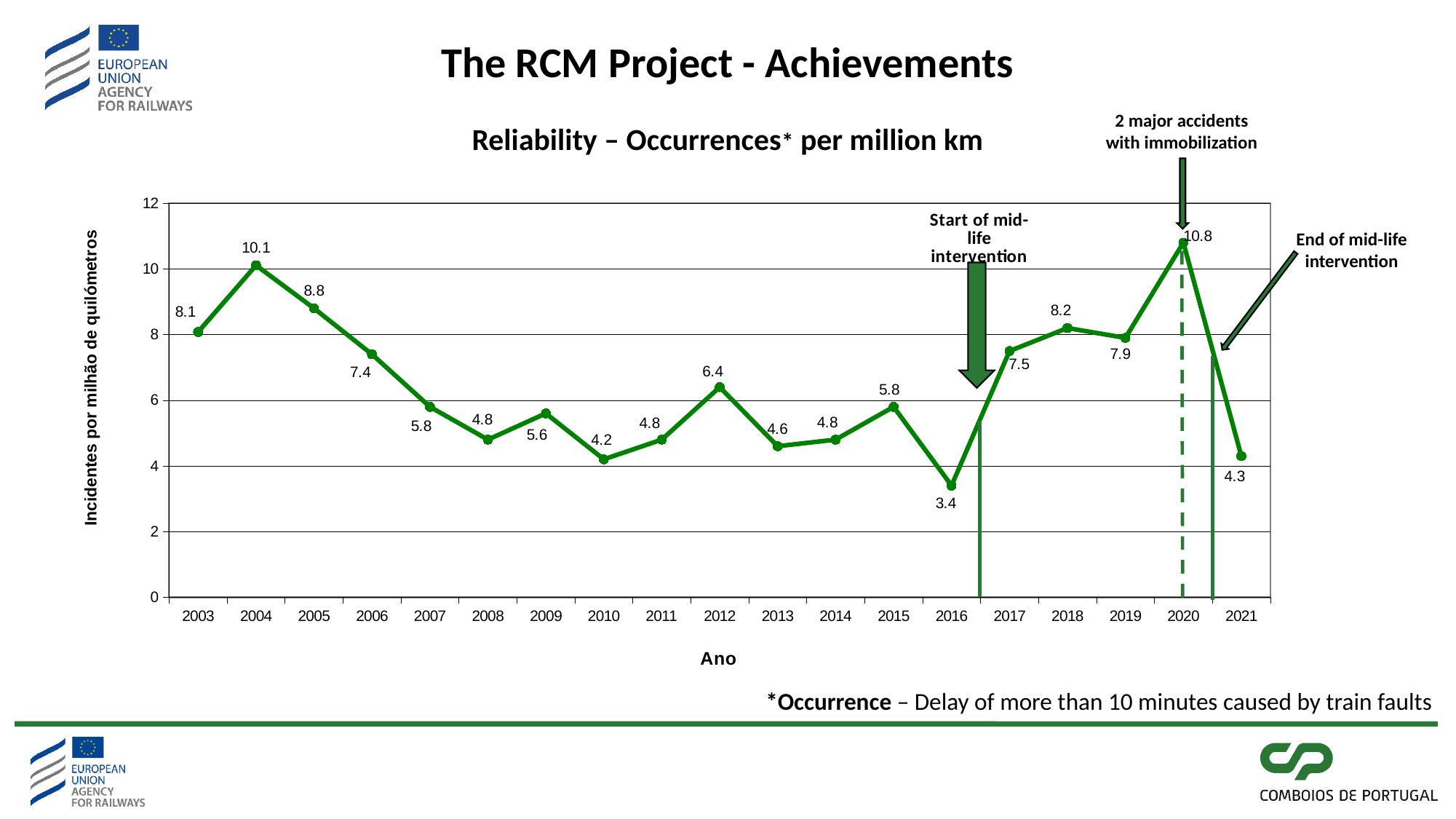
What is the title of the chart? Reliability – Occurrences* per million km What is the value for 2004? 10.1 Which year has the lowest value? 2016 Do the values rise or fall from 2004 to 2008? fall What kind of chart is shown? line chart What is the value for 2016? 3.4 Is the value for 2005 greater or less than 8? greater What is the value for 2021? 4.3 What is the difference between the values for 2020 and 2021? 6.5 Which is larger, the value for 2012 or the value for 2013? 2012 Which year has the highest value? 2020 How many years are plotted on the x axis? 19